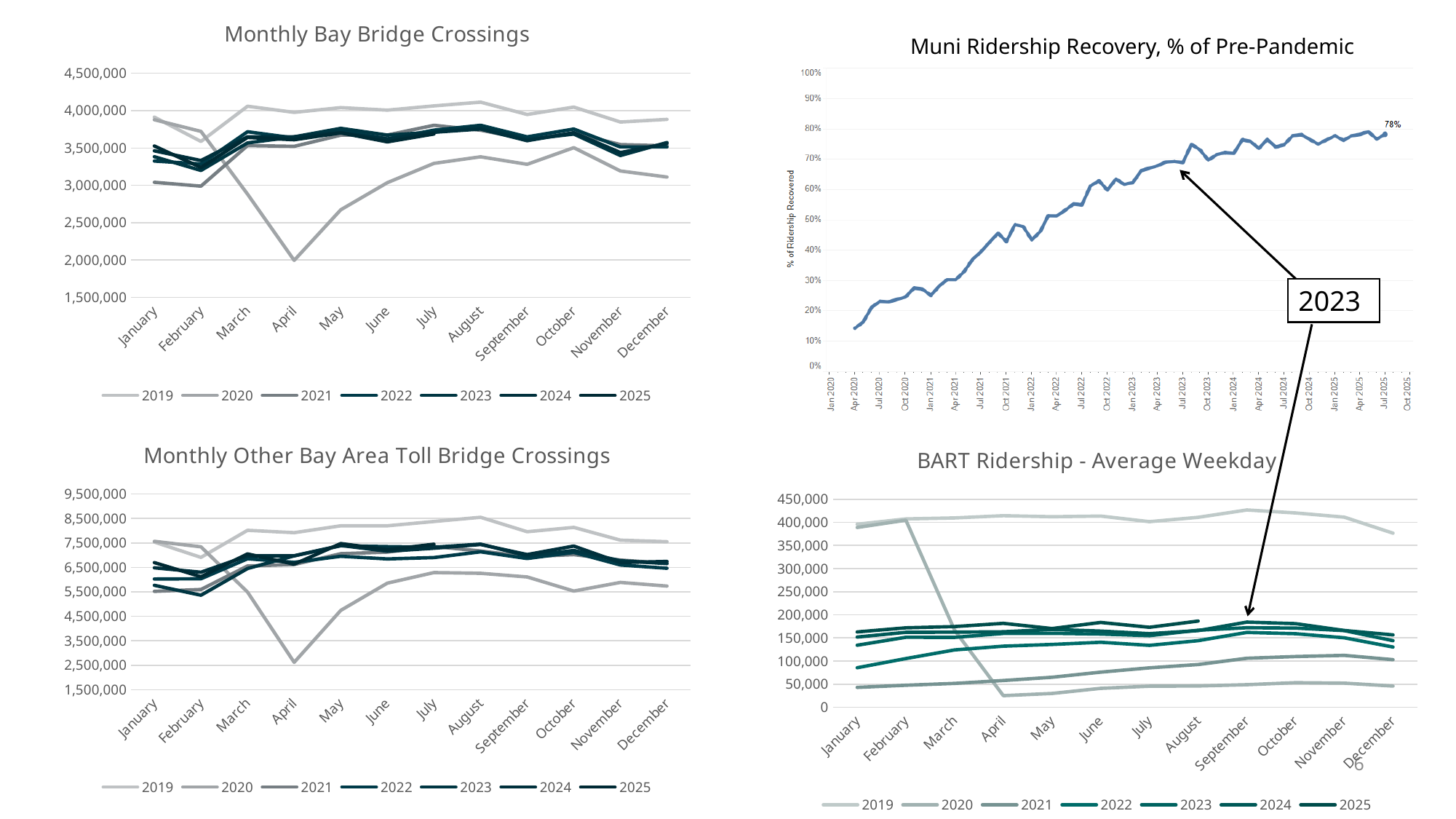
In the "Muni Ridership Recovery, % of Pre-Pandemic" chart, what value is labelled at the end of the line? 78% What kind of chart is the "Monthly Bay Bridge Crossings" chart? line chart What year is written in the boxed annotation with arrows pointing to the Muni and BART charts? 2023 In the "BART Ridership - Average Weekday" chart, which is larger in April: the 2019 value or the 2020 value? 2019 In the "Monthly Bay Bridge Crossings" chart, which year has the highest value in August? 2019 In the "Monthly Other Bay Area Toll Bridge Crossings" chart, is the 2020 value for April greater or less than 3,500,000? less In the "BART Ridership - Average Weekday" chart, is the 2019 value for January greater or less than 350,000? greater In the "Muni Ridership Recovery, % of Pre-Pandemic" chart, does the line generally rise or fall from 2020 to 2025? rise How many series does the legend of the "Monthly Bay Bridge Crossings" chart list? 7 How many series does the legend of the "BART Ridership - Average Weekday" chart list? 7 In the "Monthly Bay Bridge Crossings" chart, is the 2020 value for April greater or less than 2,500,000? less How many months are shown on the x axis of the "Monthly Bay Bridge Crossings" chart? 12